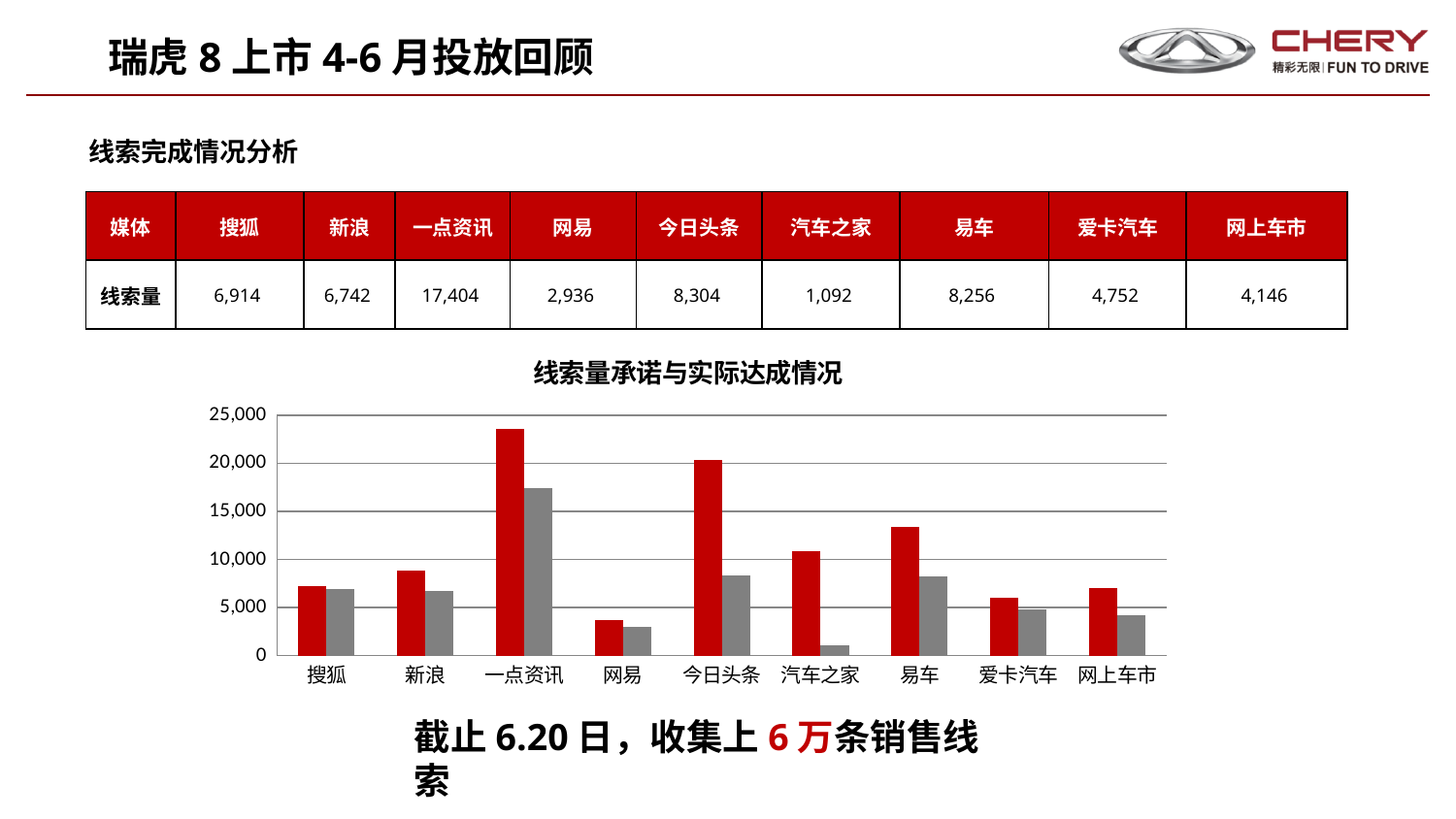
Which category has the tallest red bar in the chart? 一点资讯 Which category has the shortest gray bar in the chart? 汽车之家 What is the title of the bar chart on the slide? 线索量承诺与实际达成情况 Is the red bar for 一点资讯 greater or less than 20,000? greater Is the red bar for 易车 greater or less than 10,000? greater How many media categories are shown on the x axis of the chart? 9 Which has the taller red bar, 今日头条 or 易车? 今日头条 Which category has the tallest gray bar in the chart? 一点资讯 Is the gray bar for 今日头条 greater or less than 10,000? less Which category has the shortest red bar in the chart? 网易 What kind of chart is shown under the title 线索量承诺与实际达成情况? bar chart